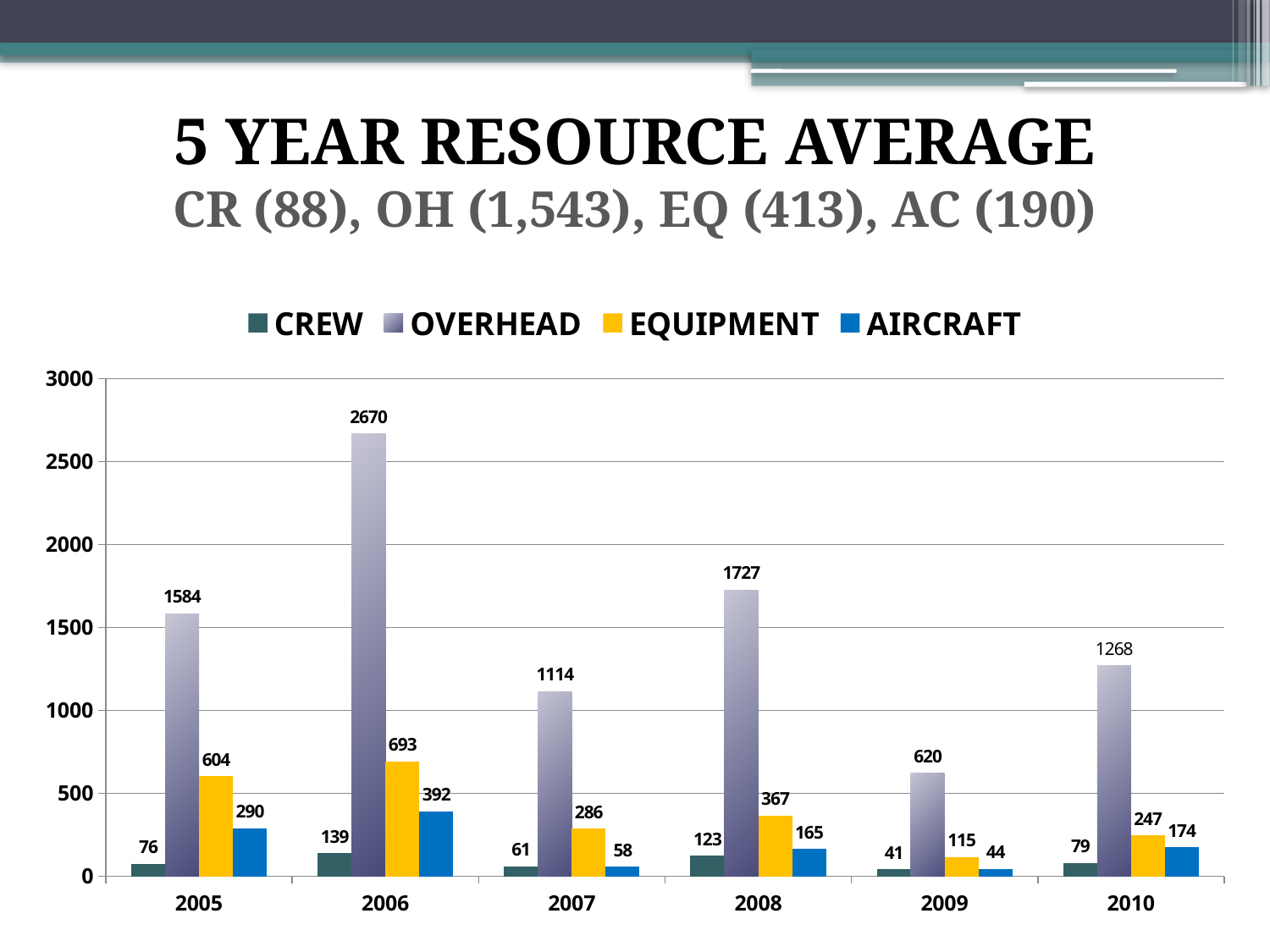
Which year has the lowest CREW value? 2009 How many series does the legend list? 4 What kind of chart is shown on the slide? bar chart What is the difference between the OVERHEAD values for 2006 and 2005? 1086 Which year has the highest OVERHEAD value? 2006 How many years are shown on the x axis? 6 What is the EQUIPMENT value for 2008? 367 What is the AIRCRAFT value for 2010? 174 What is the title of the slide? 5 YEAR RESOURCE AVERAGE Is the OVERHEAD value for 2008 greater or less than 1500? greater Which is larger, the EQUIPMENT value for 2005 or the EQUIPMENT value for 2006? 2006 What is the OVERHEAD value for 2006? 2670